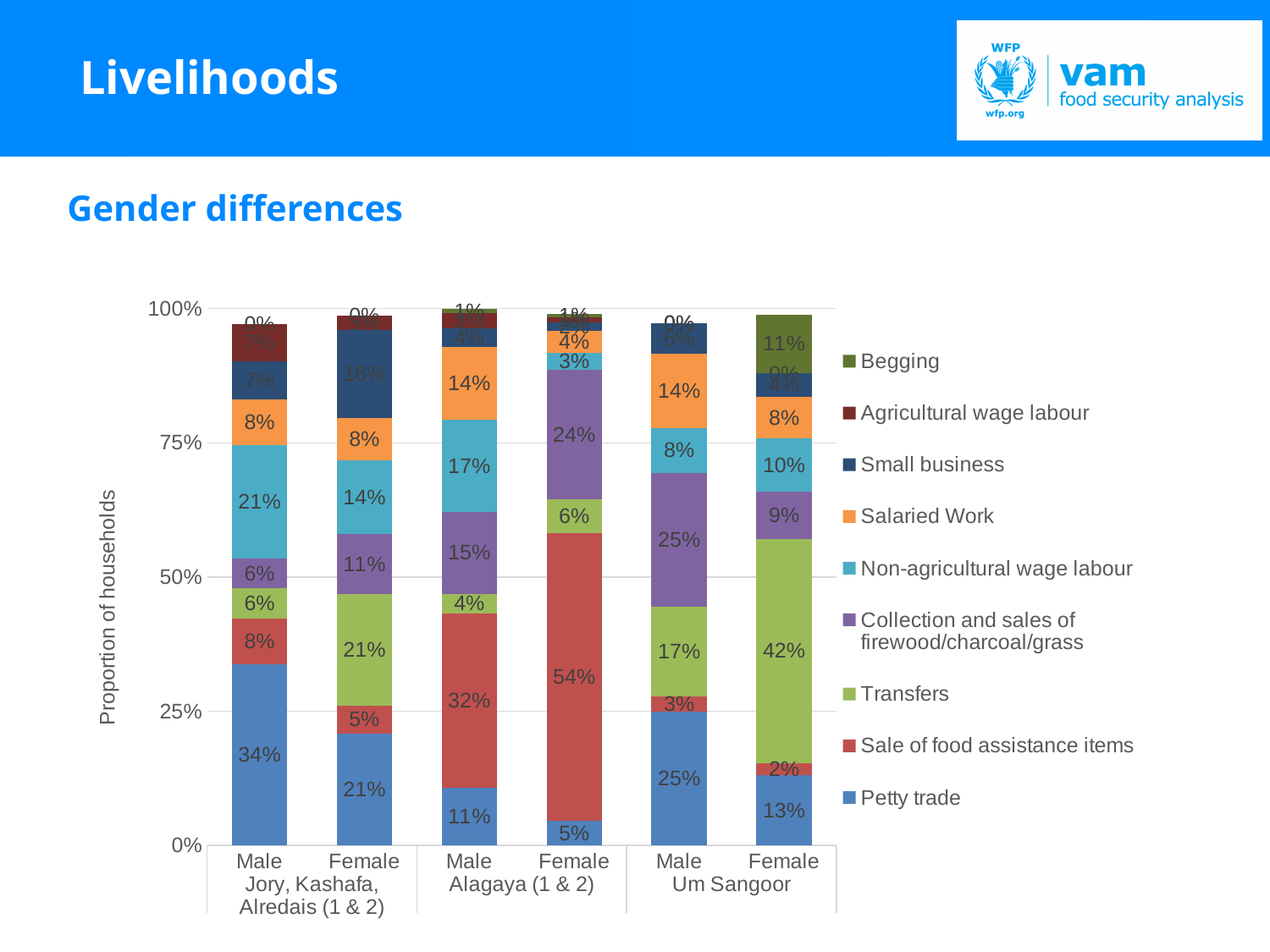
Which bar has the largest Sale of food assistance items segment? Female, Alagaya (1 & 2) What is the label on the vertical axis? Proportion of households What is the Sale of food assistance items share for Female households in Alagaya (1 & 2)? 54% What is the Collection and sales of firewood/charcoal/grass share for Male households in Um Sangoor? 25% How many bars are plotted in the chart? 6 What is the Begging share for Female households in Um Sangoor? 11% What is the Petty trade share for Male households in Jory, Kashafa, Alredais (1 & 2)? 34% What is the difference between the Transfers share for Female and Male households in Um Sangoor? 25% What kind of chart is shown on the slide? Stacked bar chart How many series does the legend list? 9 What is the Transfers share for Female households in Um Sangoor? 42% Which is larger: the Petty trade share for Male households in Jory, Kashafa, Alredais (1 & 2) or for Female households in the same area? Male